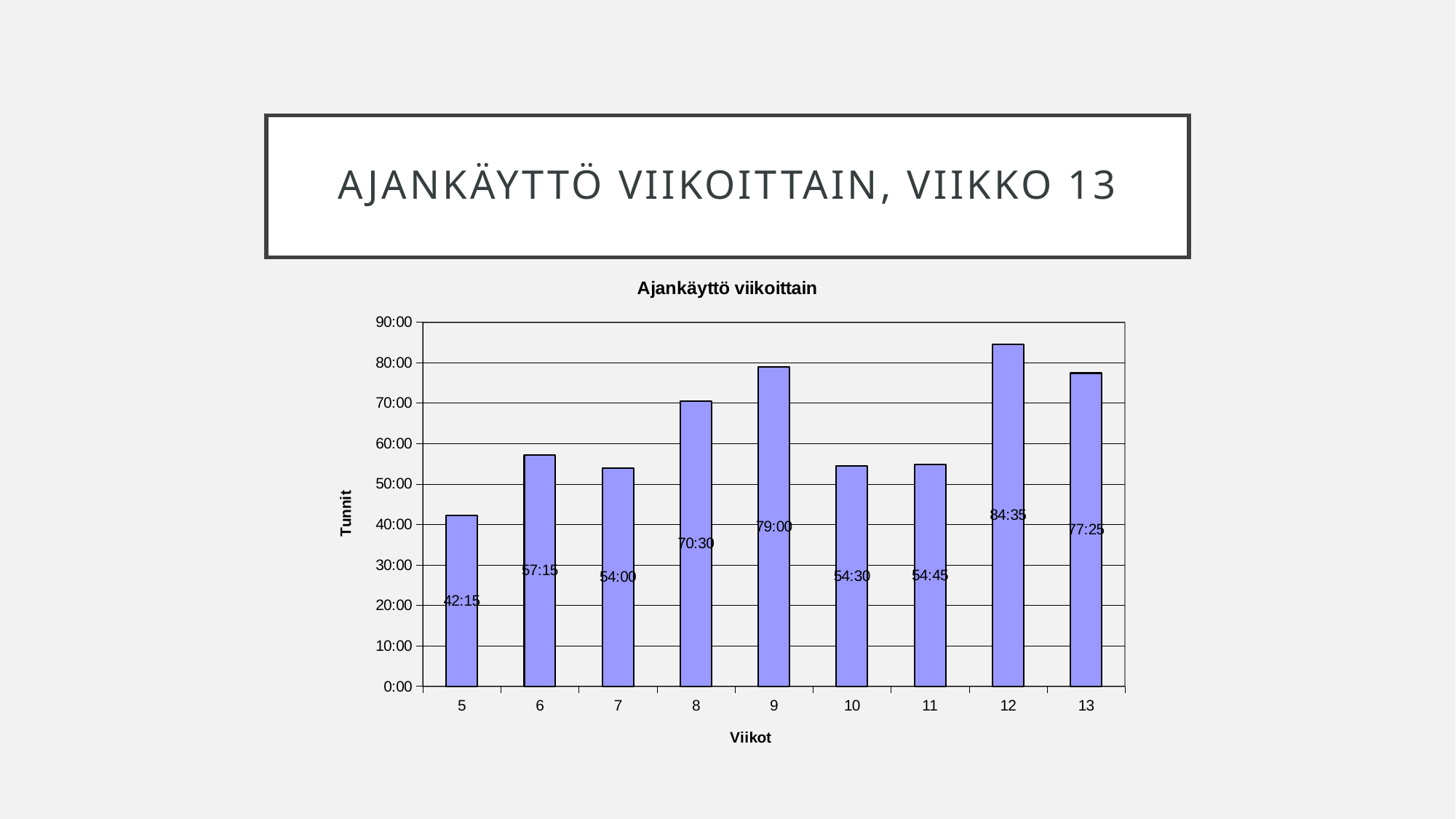
Which week has the lowest value in the chart? 5 What kind of chart is shown on the slide? bar chart Is the value for week 6 greater or less than 50:00? greater What is the value for week 5 in the chart? 42:15 What is the difference between the values for week 12 and week 5? 42:20 Which week has the highest value in the chart? 12 Which is larger, the value for week 9 or the value for week 13? week 9 What is the value for week 8 in the chart? 70:30 What is the label of the y axis of the chart? Tunnit How many weeks are shown on the x axis of the chart? 9 What is the difference between the values for week 9 and week 8? 8:30 What is the value for week 12 in the chart? 84:35